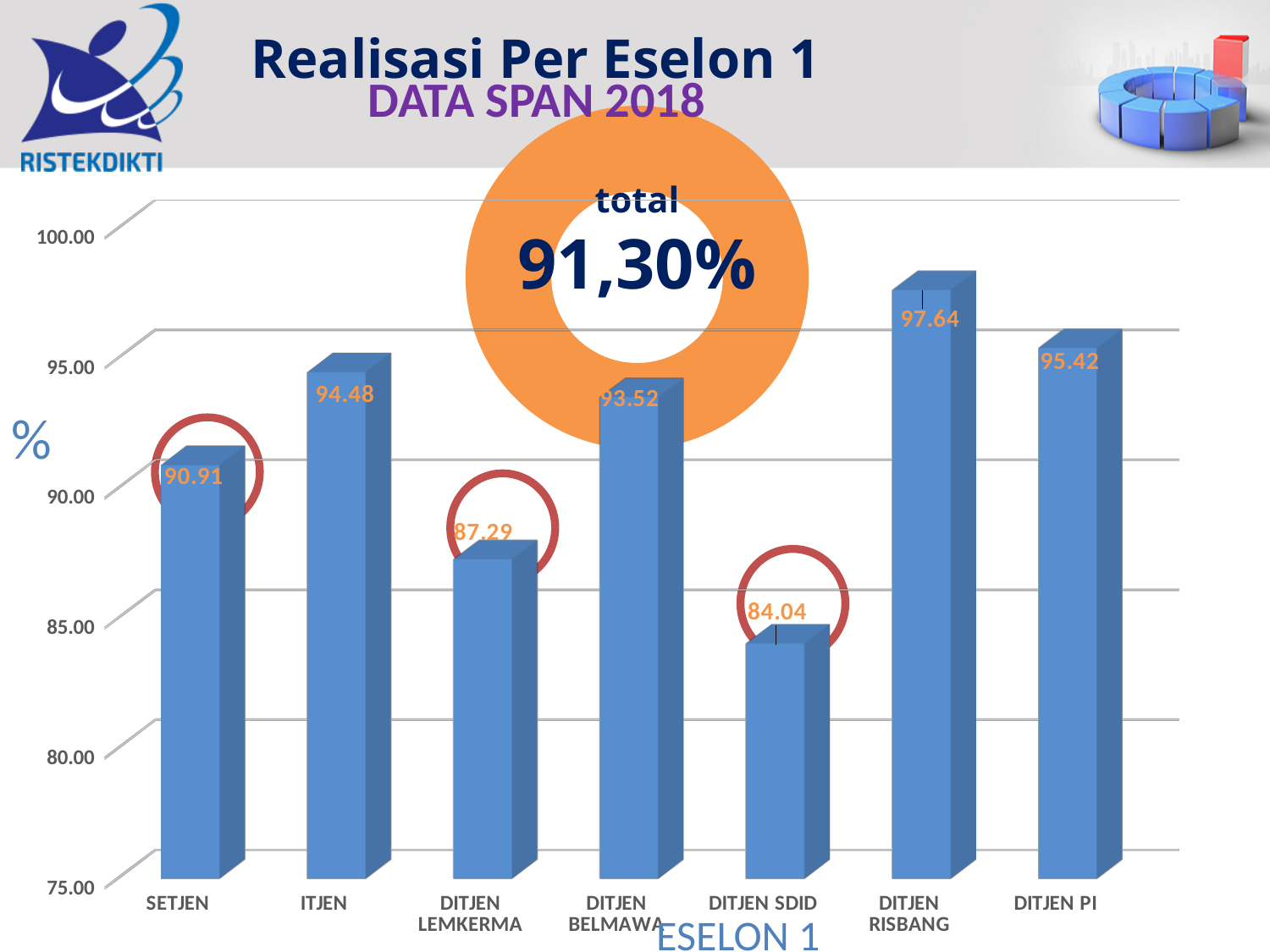
What is the difference between the values for ITJEN and DITJEN LEMKERMA? 7.19 Which is larger, the value for DITJEN BELMAWA or the value for ITJEN? ITJEN Which category has the highest value? DITJEN RISBANG What is the value for DITJEN PI? 95.42 What kind of chart is shown on the slide? bar chart What is the value for DITJEN RISBANG? 97.64 Is the value for DITJEN LEMKERMA greater or less than 90.00? less What is the value for DITJEN SDID? 84.04 Which category has the lowest value? DITJEN SDID What is the value for SETJEN? 90.91 What total percentage is shown in the orange circle on the chart? 91,30% How many categories are shown on the x axis? 7